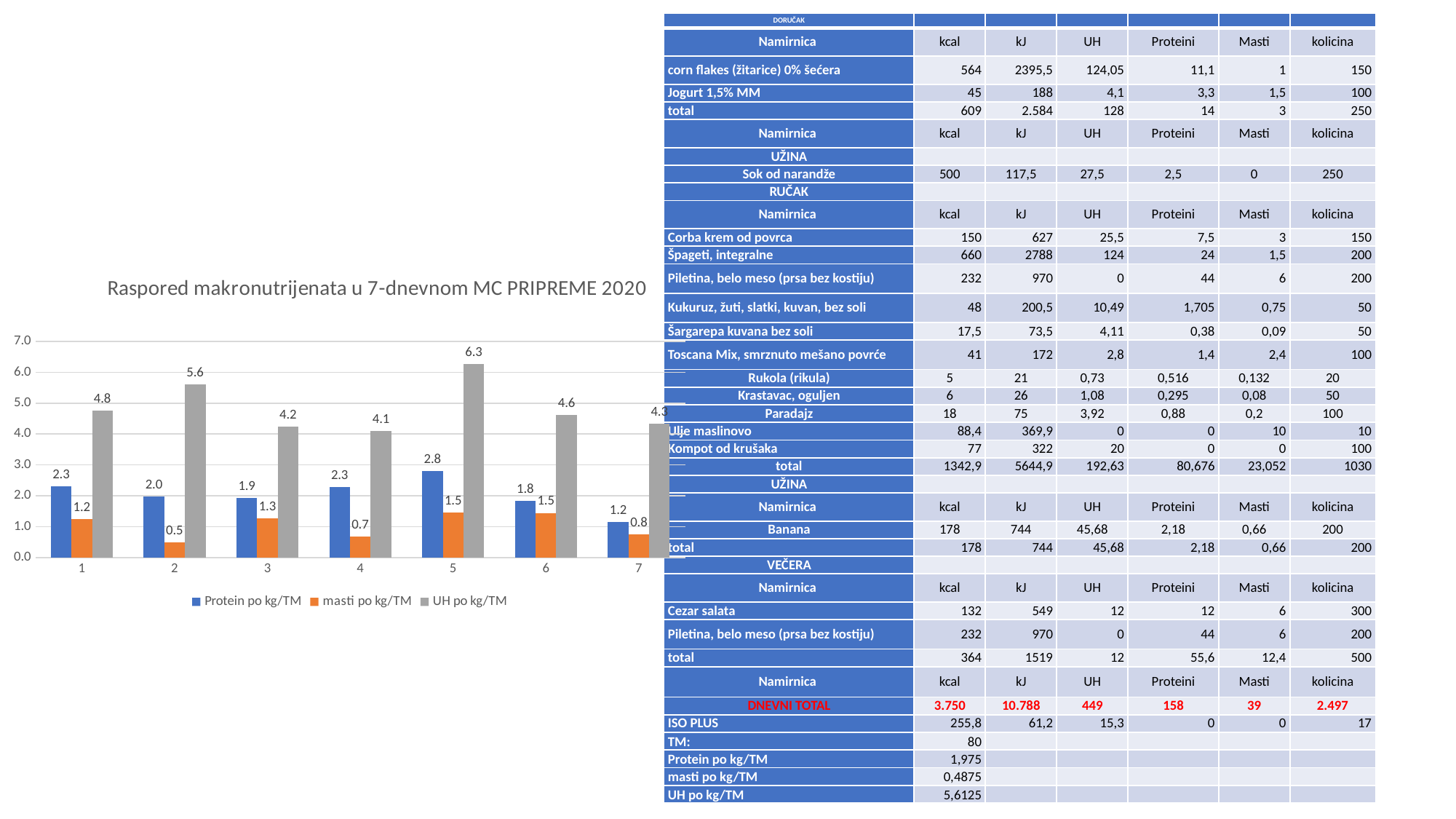
What type of chart is shown on the slide? bar chart What is the difference between UH po kg/TM on day 5 and day 4? 2.2 What is the value of Protein po kg/TM for day 5? 2.8 How many categories (days) are shown on the x axis of the chart? 7 How many series does the chart legend list? 3 On which day is UH po kg/TM highest? 5 On which day is Protein po kg/TM lowest? 7 What is the value of masti po kg/TM for day 2? 0.5 What is the value of UH po kg/TM for day 3? 4.2 Is the value of UH po kg/TM for day 2 greater or less than 5.0? greater Which is larger: masti po kg/TM on day 3 or on day 4? day 3 What is the title of the chart? Raspored makronutrijenata u 7-dnevnom MC PRIPREME 2020